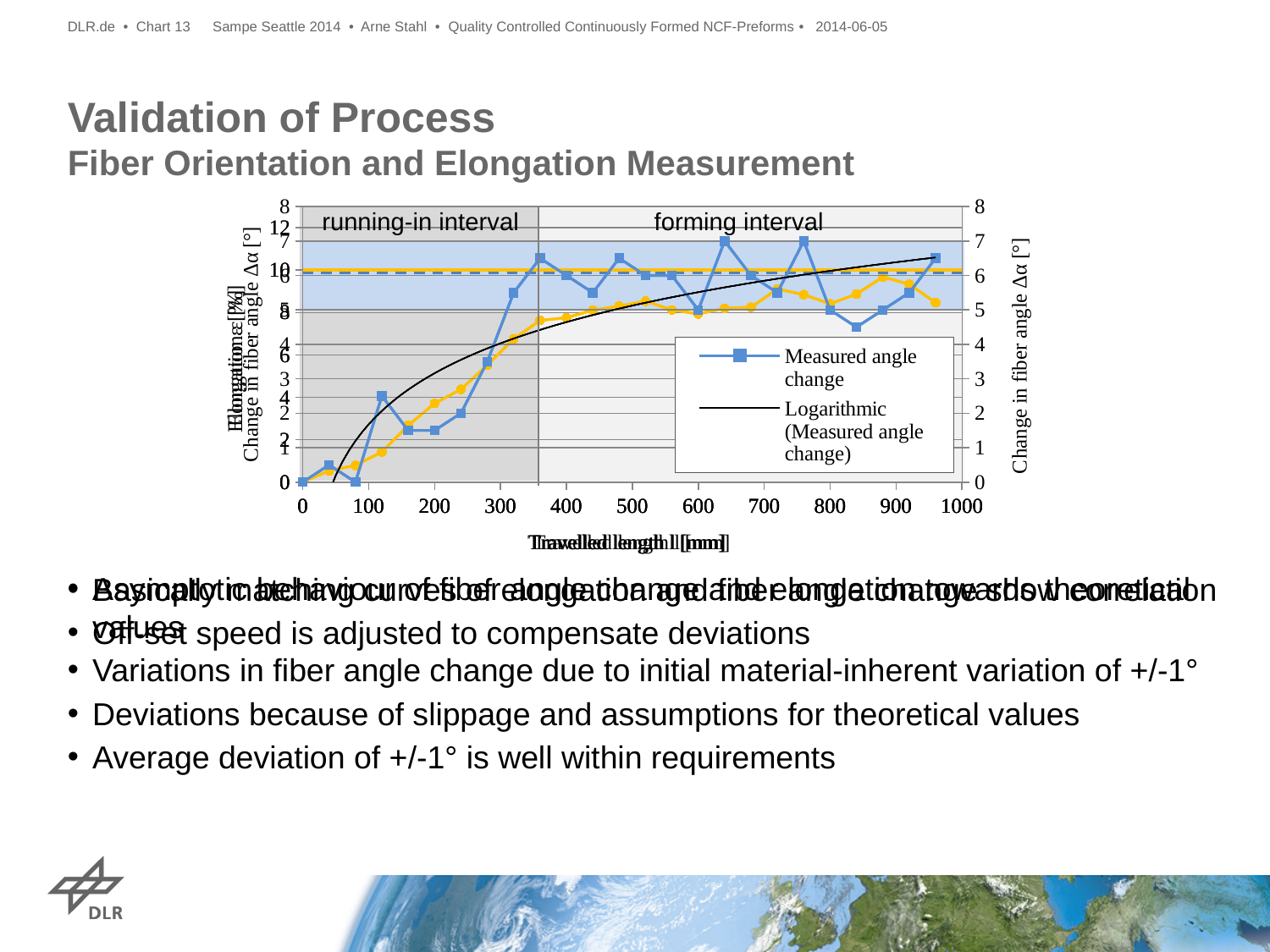
What is the maximum value shown on the right-hand y axis? 8 Which of the two intervals marked on the chart comes first along the x axis, the running-in interval or the forming interval? running-in interval Is the measured angle change at a travelled length of 640 mm greater or less than 6? greater What is the maximum value shown on the x axis? 1000 Is the measured angle change at a travelled length of 360 mm greater or less than 5? greater What is the label of the x axis? Travelled length l [mm] Is the measured angle change at a travelled length of 80 mm greater or less than 1? less Which series is drawn with square markers? Measured angle change What is the label of the right-hand y axis? Change in fiber angle Δα [°] Does the logarithmic curve rise or fall as travelled length increases? rise How many series does the legend list? 2 What kind of chart is shown on the slide? line chart